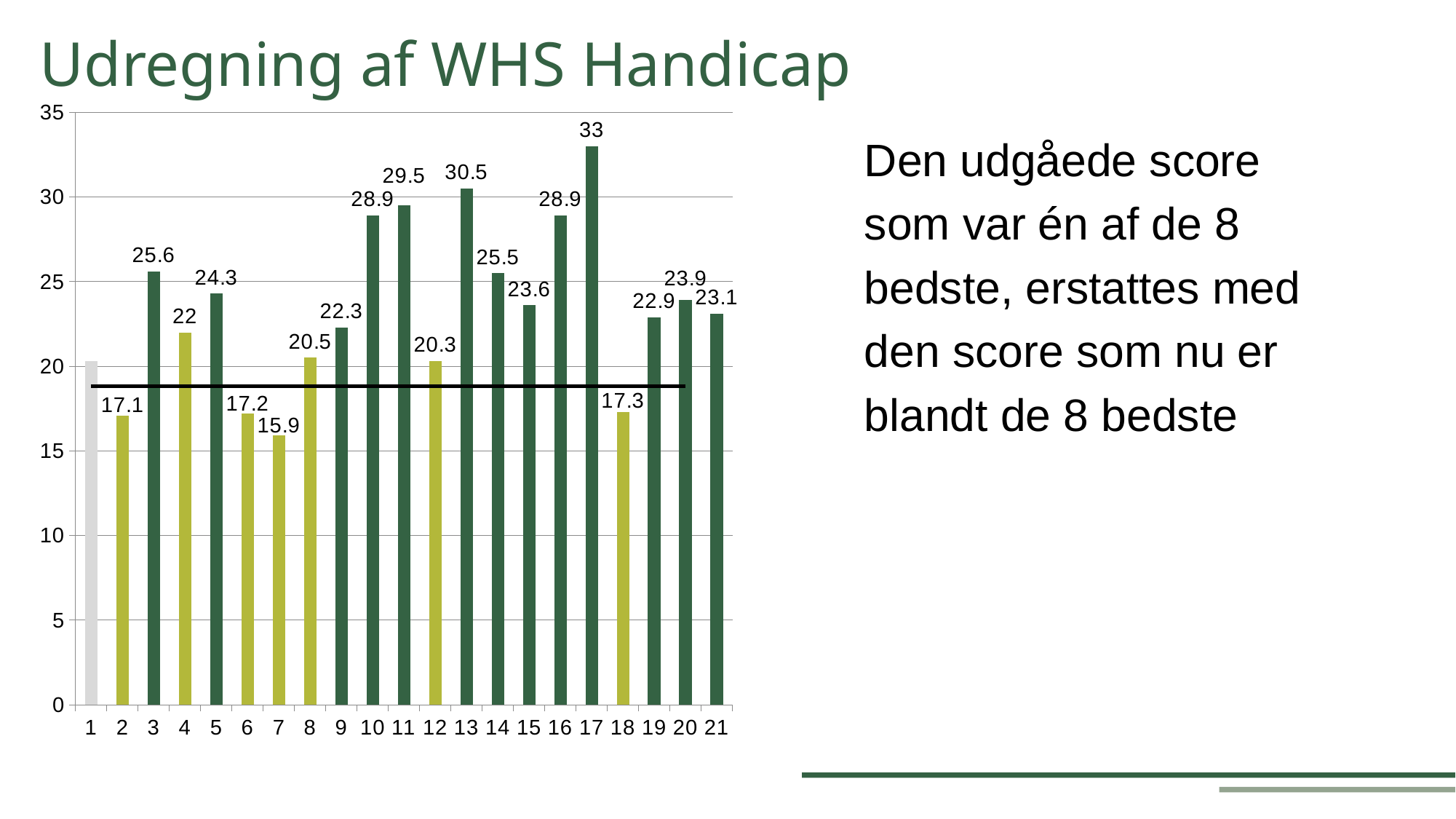
Which category has the lowest value? 7 How many categories are shown on the x axis? 21 Which category has the highest value? 17 What is the difference between the values for category 3 and category 2? 8.5 What is the value for category 17? 33 What is the difference between the values for category 17 and category 13? 2.5 What kind of chart is shown on the slide? bar chart with a horizontal line (combination bar and line chart) How many bars are coloured light green (yellow-green) rather than dark green or grey? 7 Which is larger, the value for category 10 or the value for category 14? 10 What is the value for category 11? 29.5 What is the value for category 7? 15.9 Is the value for category 1 greater or less than 15? greater